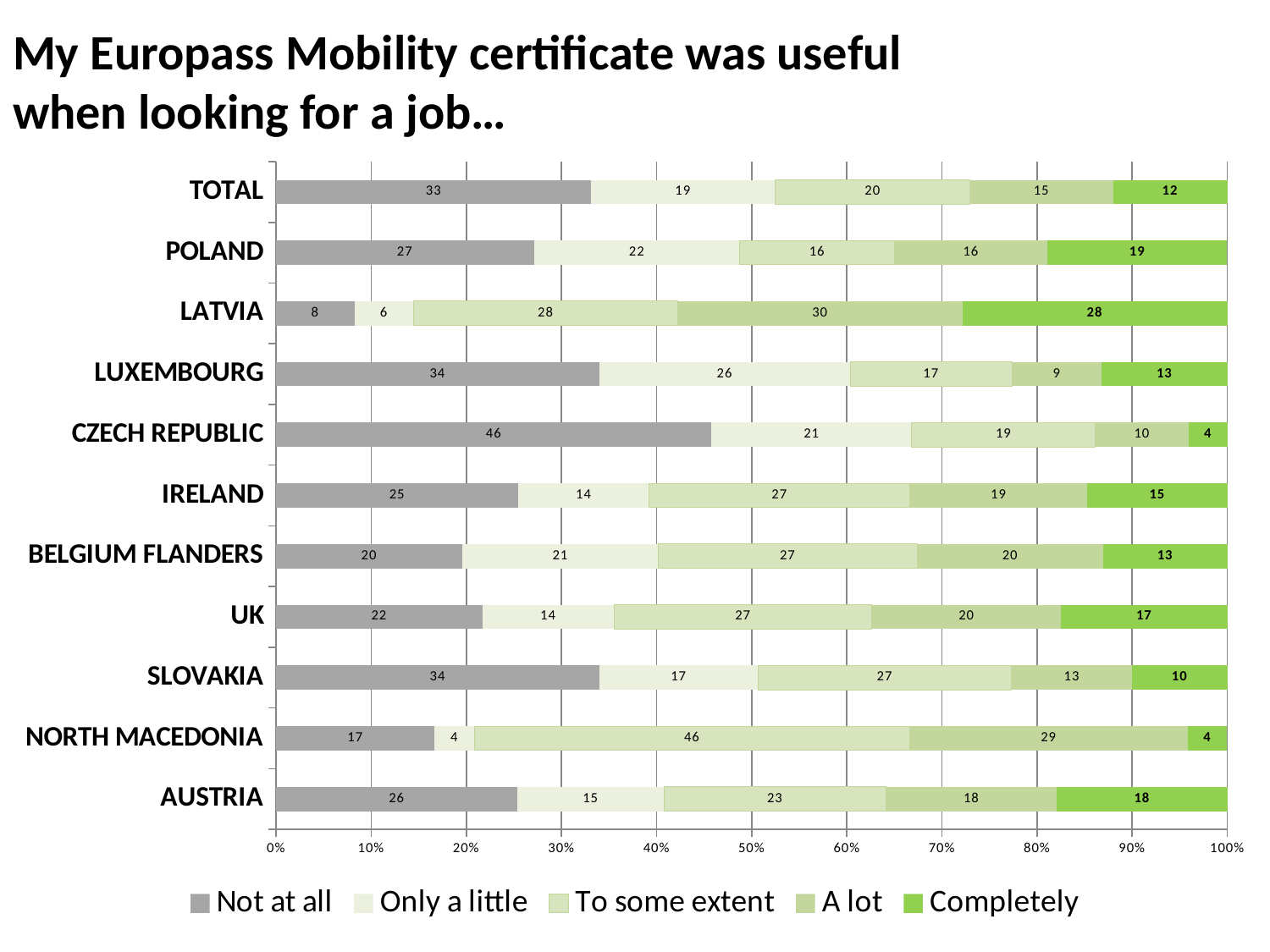
Which country has the highest 'Not at all' value? CZECH REPUBLIC What is the 'A lot' value for TOTAL? 15 What kind of chart is shown on the slide? Stacked bar chart Which is larger, the 'Only a little' value for LUXEMBOURG or for IRELAND? LUXEMBOURG What is the 'Not at all' value for CZECH REPUBLIC? 46 What is the difference between the 'Completely' values for POLAND and CZECH REPUBLIC? 15 How many series does the legend list? 5 What is the 'Completely' value for LATVIA? 28 How many categories (rows) are shown on the chart? 11 Which legend entry is shown in the darkest green colour? Completely What is the 'To some extent' value for NORTH MACEDONIA? 46 Which country has the lowest 'Not at all' value? LATVIA